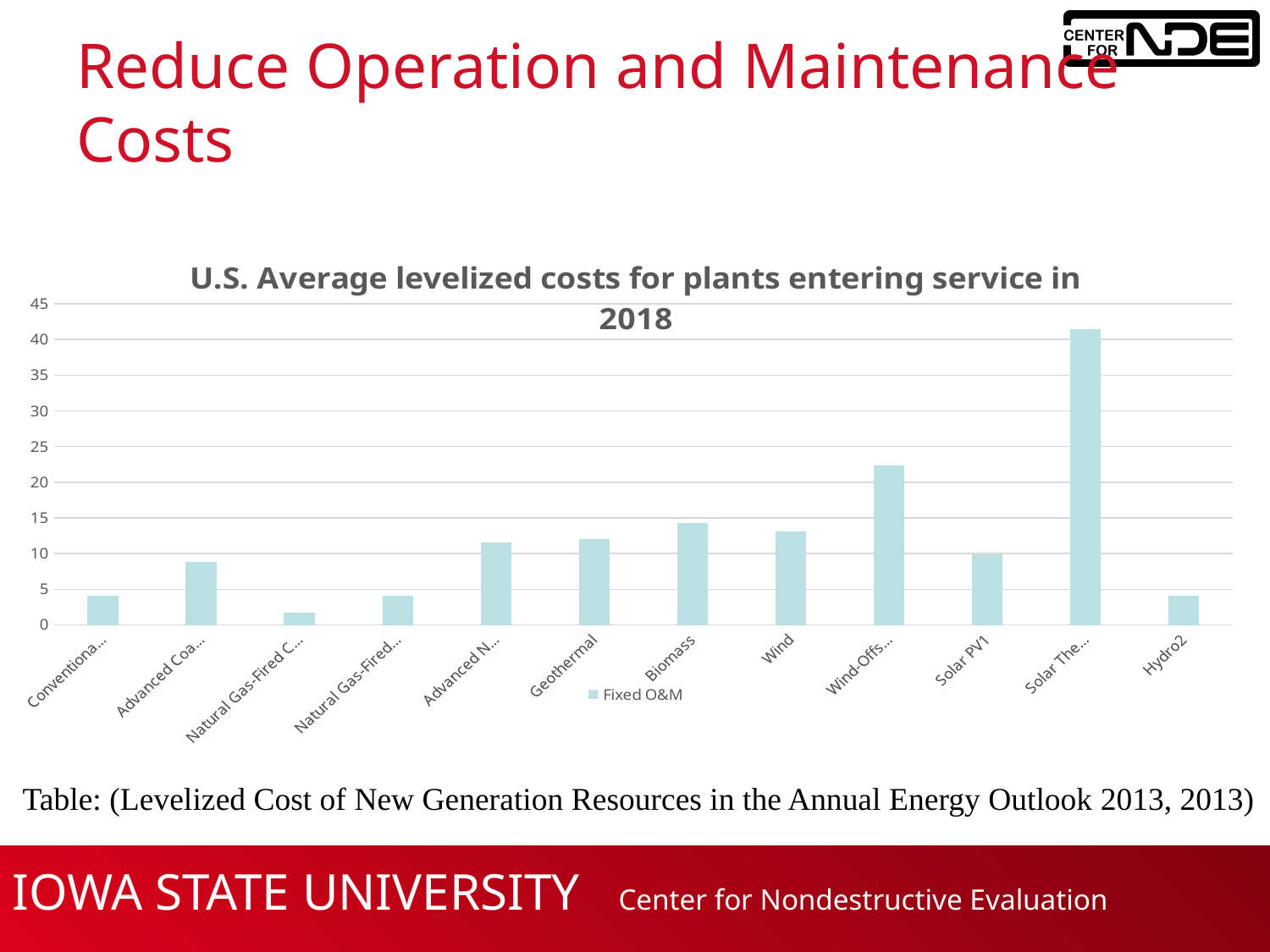
How many categories (bars) are plotted in the chart? 12 Is the value for Wind greater or less than 10? greater Is the value for Geothermal greater or less than 10? greater What is the title of the chart? U.S. Average levelized costs for plants entering service in 2018 Is the value for Biomass greater or less than 15? less What kind of chart is shown on the slide? bar chart What is the name of the series shown in the legend? Fixed O&M Which has the larger value, Biomass or Solar PV1? Biomass Which has the larger value, Geothermal or Hydro2? Geothermal How many series does the legend list? 1